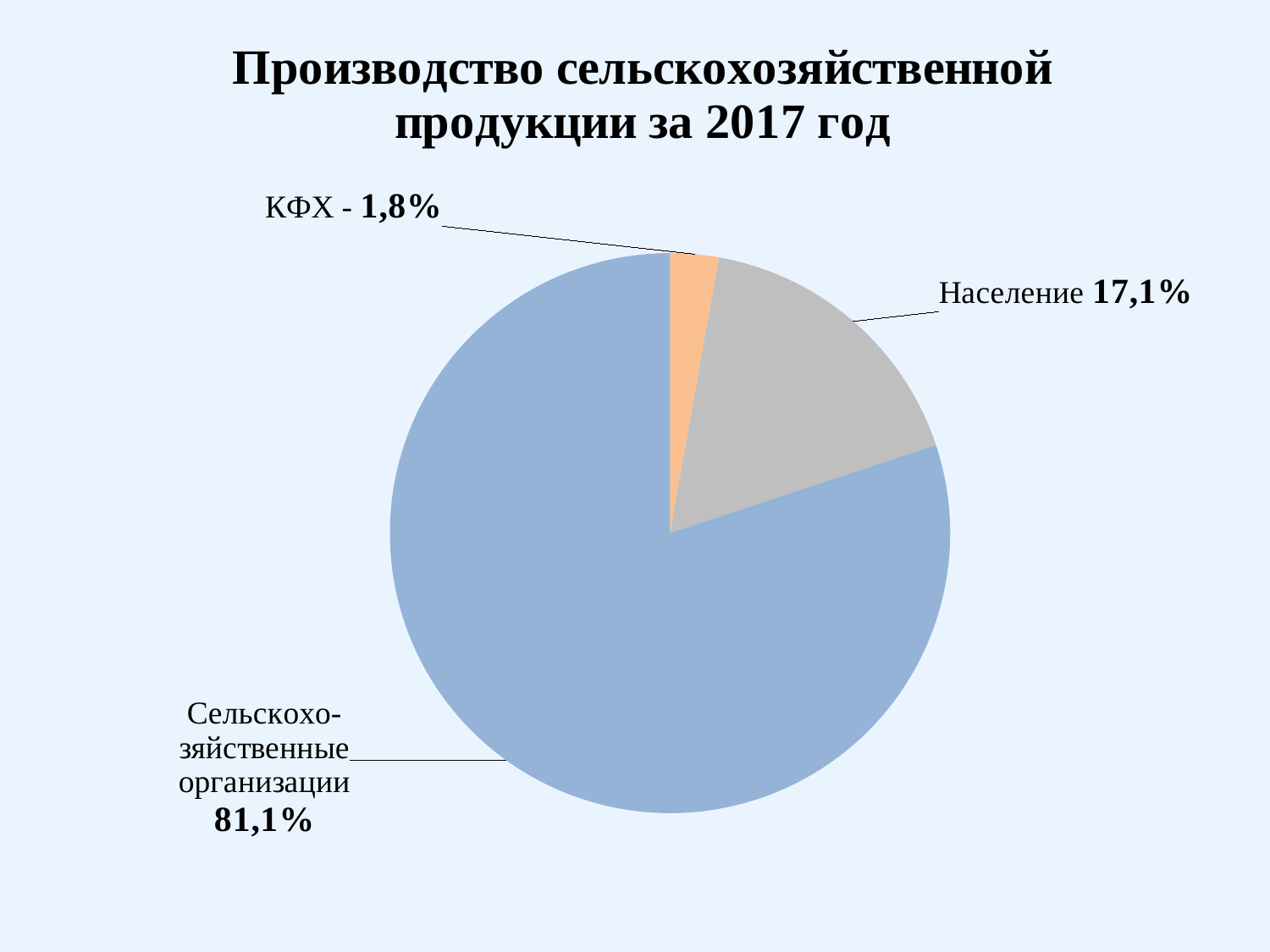
What share of agricultural production in 2017 is attributed to КФХ? 1,8% Which category has the largest share of the pie? Сельскохозяйственные организации What is the difference in percentage points between the shares of Население and КФХ? 15,3 How many slices does the pie chart have? 3 What colour is the slice for КФХ? orange Which is larger, the share of Население or the share of КФХ? Население What share of agricultural production in 2017 is attributed to Сельскохозяйственные организации? 81,1% What kind of chart is shown on the slide? pie chart What is the title of the chart? Производство сельскохозяйственной продукции за 2017 год What share of agricultural production in 2017 is attributed to Население? 17,1% What is the difference in percentage points between the shares of Сельскохозяйственные организации and Население? 64,0 Which category has the smallest share of the pie? КФХ